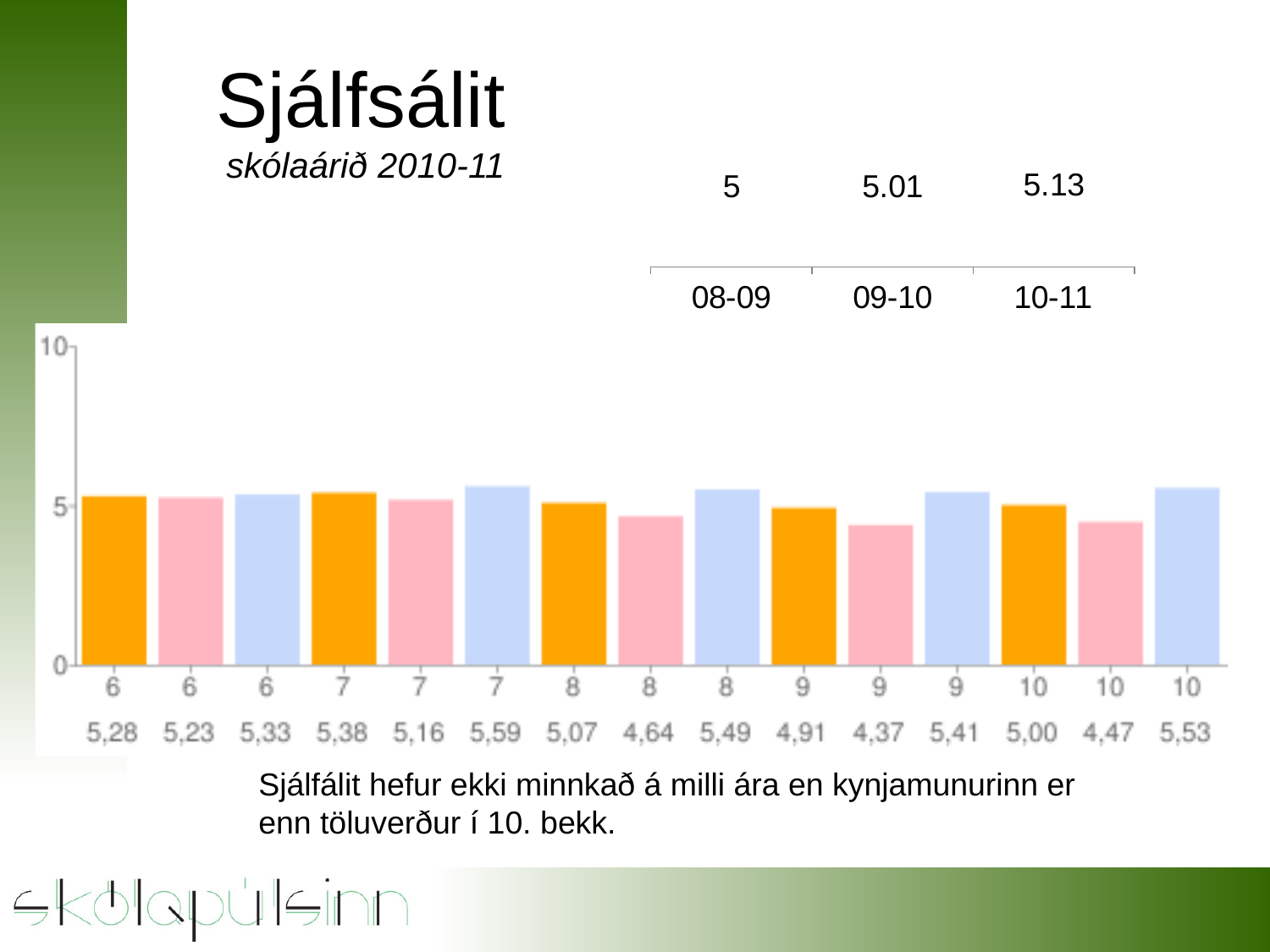
In the large bar chart, what is the highest value shown among all bars? 5,59 In the small chart at the top right, how many school years are shown? 3 In the large bar chart, what is the lowest value shown among all bars? 4,37 In the large bar chart, what is the difference between the blue bar for grade 7 (5,59) and the pink bar for grade 7 (5,16)? 0,43 In the small chart at the top right, what is the value for 10-11? 5.13 In the small chart at the top right, which school year has the highest value? 10-11 In the large bar chart, how many bars are plotted in total? 15 In the small chart at the top right, what is the value for 08-09? 5 In the small chart at the top right, do the values rise or fall from 08-09 to 10-11? rise In the large bar chart, which is larger: the orange bar for grade 6 or the orange bar for grade 10? the orange bar for grade 6 What kind of chart is the large chart at the bottom of the slide? bar chart In the large bar chart, what is the maximum value shown on the vertical axis? 10